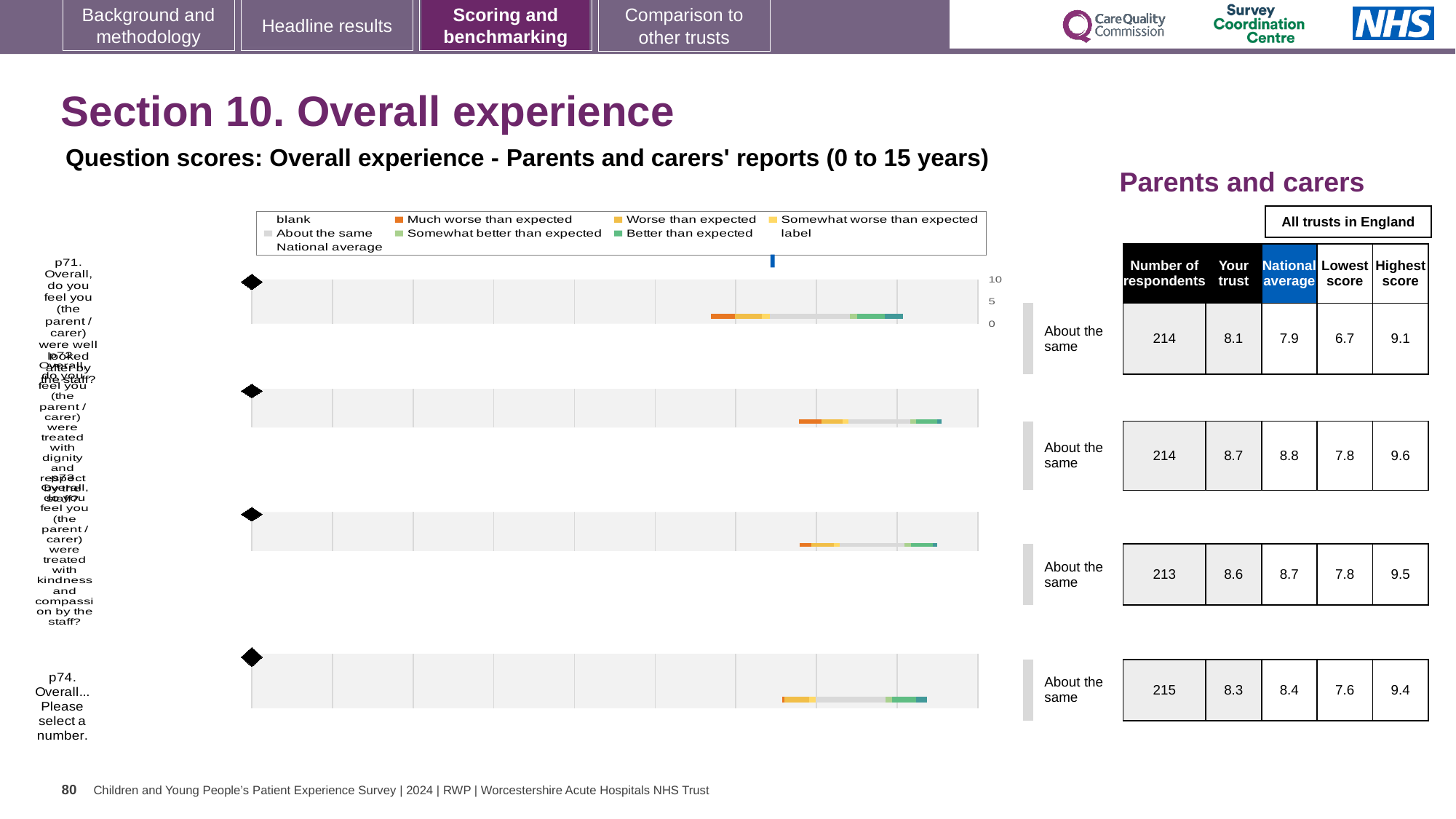
In the table beside the chart, what is the 'Your trust' score for p71 (Overall, do you feel you were well looked after by the staff)? 8.1 For p71, what is the difference between the highest score (9.1) and the lowest score (6.7) in the table? 2.4 What colour does the legend use for 'Much worse than expected'? orange What benchmark category is shown next to the p71 bar? About the same How many of the plotted questions are labelled 'About the same'? 4 What kind of chart is shown on the slide? bar chart For p72, which is larger in the table: the 'Your trust' score or the 'National average'? National average Which question has the highest 'Your trust' score in the table beside the chart? p72 What is the subtitle above the chart? Question scores: Overall experience - Parents and carers' reports (0 to 15 years) In the table beside the chart, how many respondents answered p74 (Overall... Please select a number)? 215 How many question bars are plotted in the chart? 4 How many entries does the chart legend list? 9